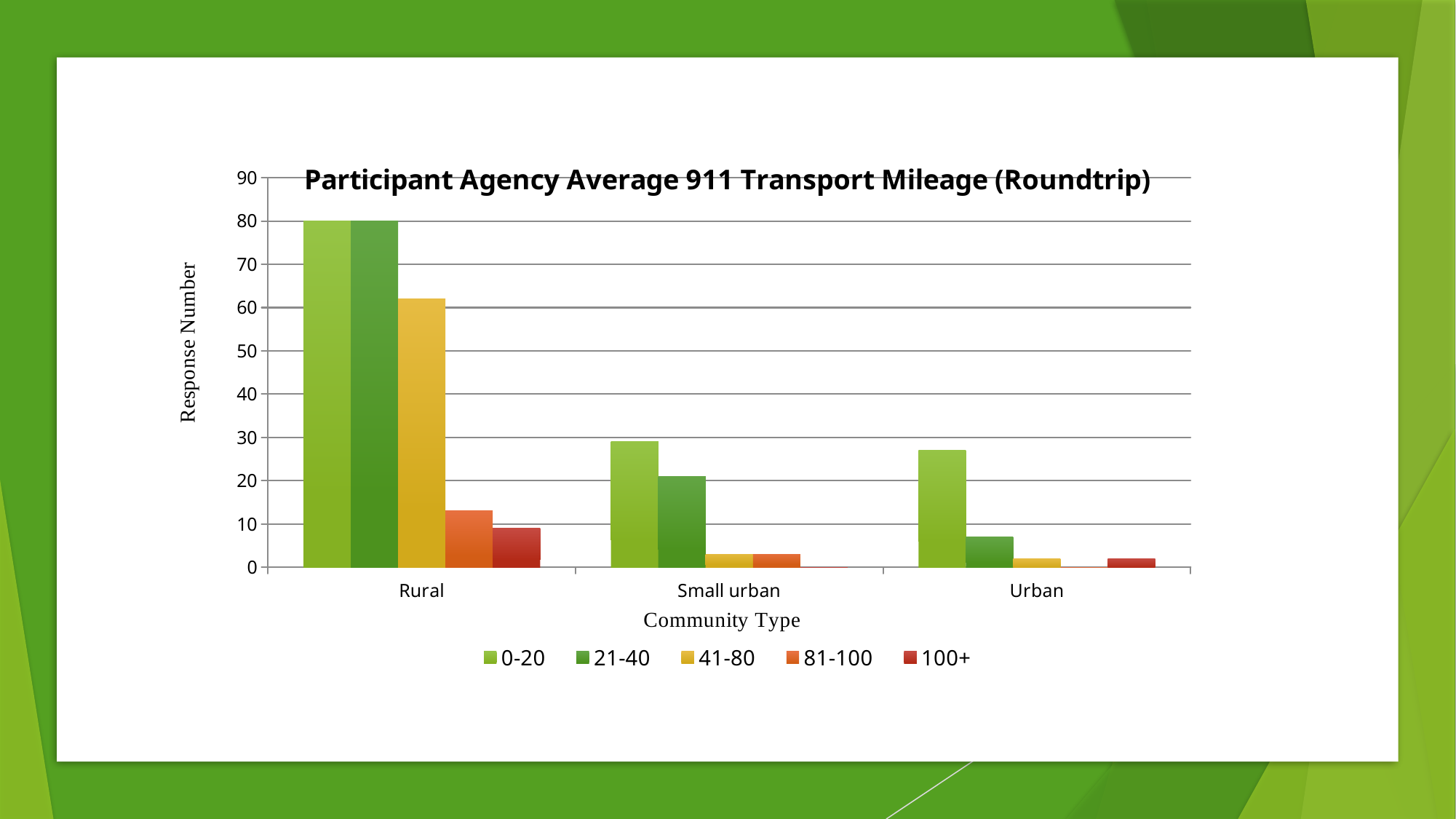
What is the label of the vertical axis? Response Number What is the value for the 0-20 series in the Rural category? 80 How many series does the legend list? 5 Which community type has the highest value for the 0-20 series? Rural Is the value for the 21-40 series in the Urban category greater or less than 10? less How many community types are shown on the x axis? 3 In the Small urban category, which is larger: the 0-20 series or the 21-40 series? 0-20 Is the value for the 41-80 series in the Rural category greater or less than 50? greater Does the 0-20 series rise or fall from Rural to Urban along the x axis? fall What type of chart is shown on the slide? bar chart Is the value for the 0-20 series in the Small urban category greater or less than 20? greater What is the title of the chart? Participant Agency Average 911 Transport Mileage (Roundtrip)